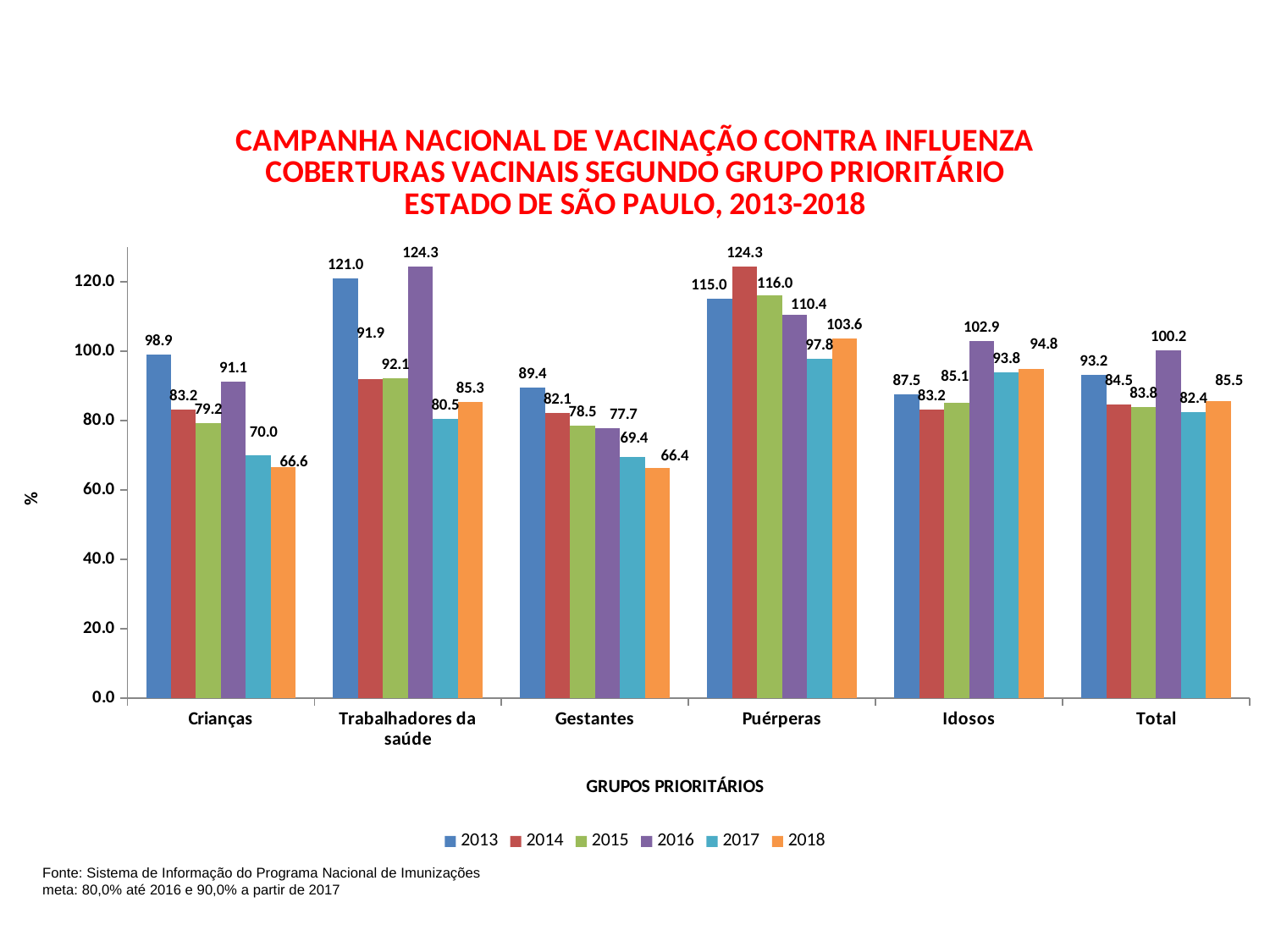
Which priority group has the lowest value in 2018? Gestantes What is the value for Idosos in 2016? 102.9 Which is larger for Trabalhadores da saúde: the 2014 value or the 2015 value? 2015 What is the value for Total in 2018? 85.5 How many series does the legend list? 6 Is the value for Gestantes in 2017 greater or less than 80.0? less What is the difference between the 2013 and 2018 values for Crianças? 32.3 What is the value for Puérperas in 2014? 124.3 What is the value for Crianças in 2013? 98.9 Which priority group has the highest value in 2017? Puérperas What kind of chart is shown on the slide? Bar chart How many priority groups are shown on the x axis? 6